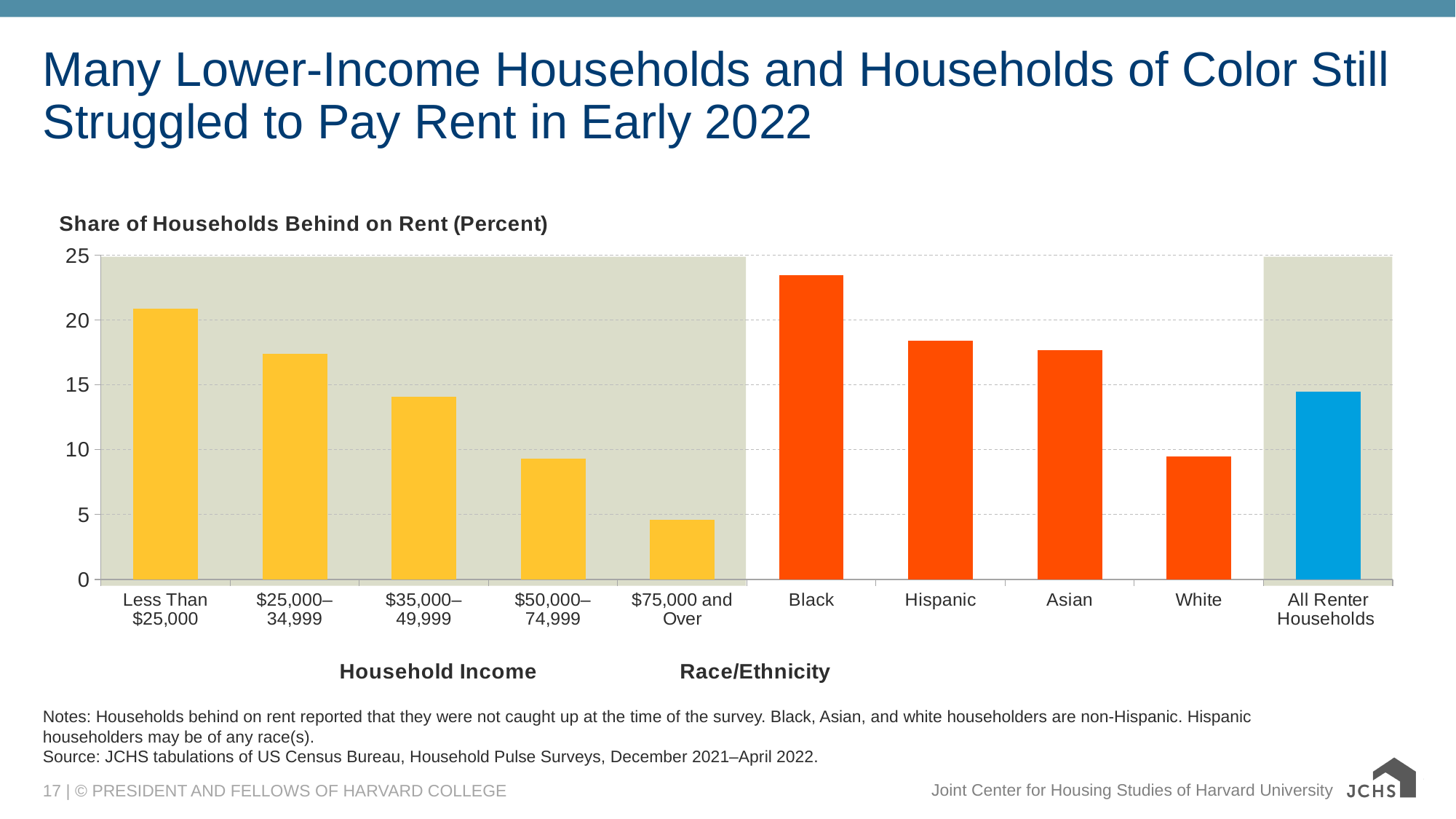
Is the value for $75,000 and Over greater or less than 5? less Is the value for White greater or less than 10? less Which is larger, the value for Less Than $25,000 or the value for $25,000–34,999? Less Than $25,000 Do the values rise or fall as household income increases from Less Than $25,000 to $75,000 and Over? Fall Is the value for Less Than $25,000 greater or less than 20? greater Which category has the lowest share of households behind on rent? $75,000 and Over How many categories are plotted in the chart? 10 Which is larger, the value for Hispanic or the value for White? Hispanic What kind of chart is shown on the slide? Bar chart What is the title of the chart's vertical measure shown above the plot? Share of Households Behind on Rent (Percent) Which category has the highest share of households behind on rent? Black